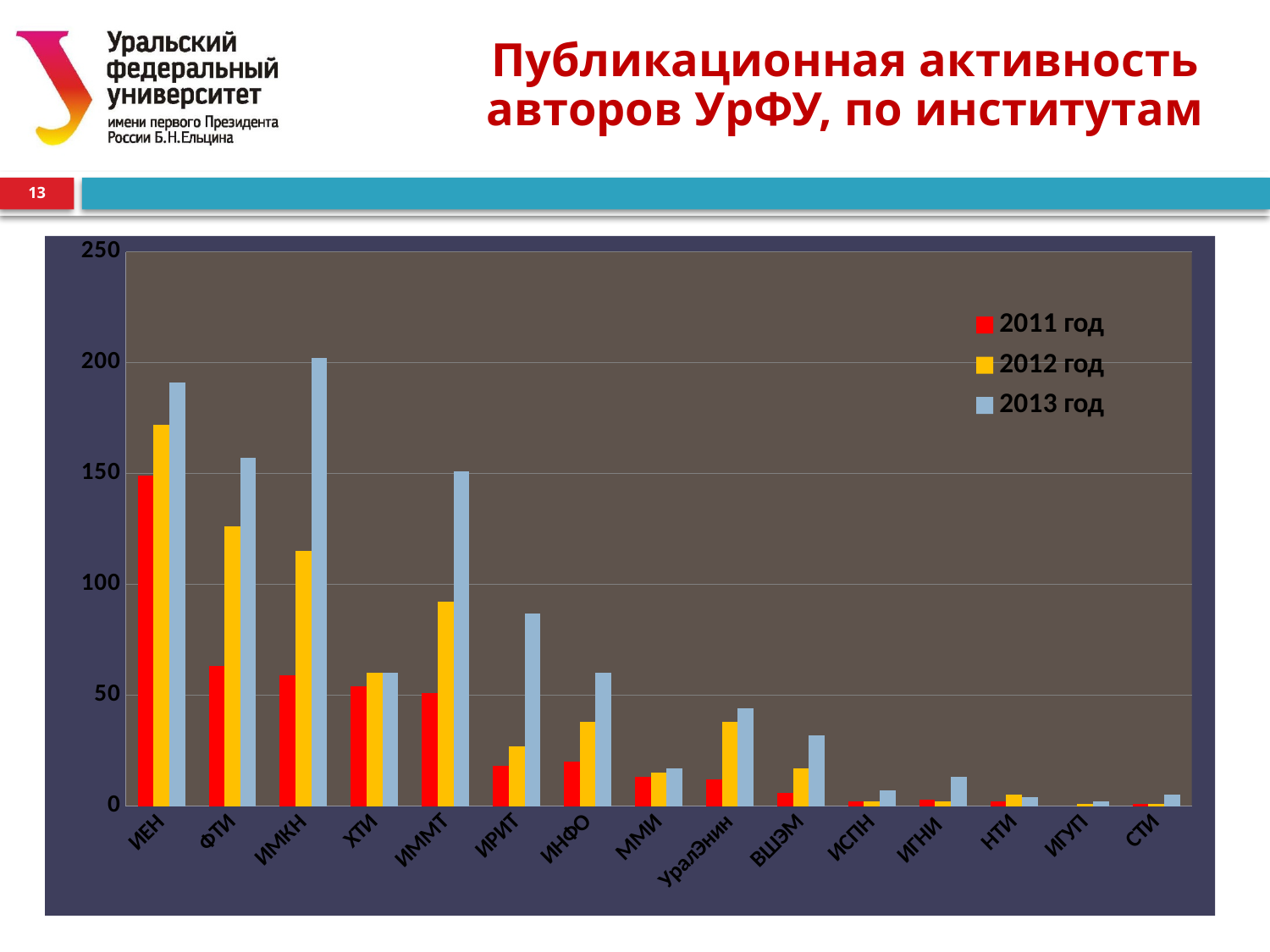
How many institutes (categories) are shown on the x axis? 15 Which institute has the highest value for 2012 год? ИЕН Which is larger: the 2013 год value for ИРИТ or the 2013 год value for ИнФО? ИРИТ How many series does the legend list? 3 Is the value for ИЕН in 2013 год greater or less than 200? less Is the value for ИРИТ in 2013 год greater or less than 100? less Which institute has the highest value for 2011 год? ИЕН Do the values for ИЕН rise or fall from 2011 год to 2013 год? rise Which colour represents the 2012 год series in the legend? yellow What kind of chart is shown on the slide? bar chart Which institute has the highest value for 2013 год? ИМКН Is the value for ФТИ in 2012 год greater or less than 100? greater